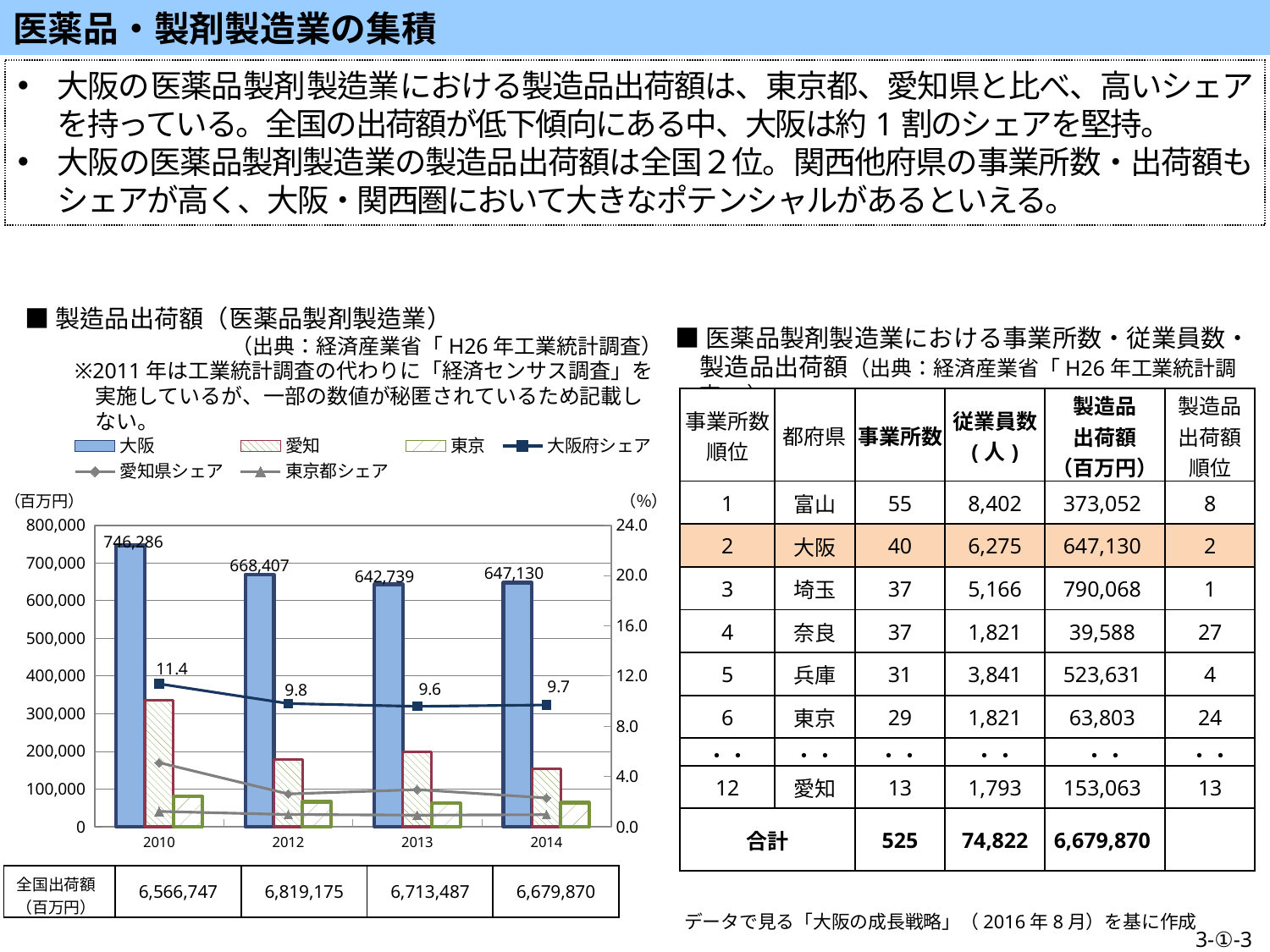
What is the value for 大阪 in 2010 in the 製造品出荷額 chart? 746,286 How many years are shown on the x axis of the 製造品出荷額 chart? 4 Is the value for 愛知 in 2010 greater or less than 300,000 in the 製造品出荷額 chart? greater Does the 大阪府シェア line rise or fall from 2010 to 2013 in the 製造品出荷額 chart? fall What is the 大阪府シェア value for 2013 in the 製造品出荷額 chart? 9.6 What is the 大阪府シェア value for 2012 in the 製造品出荷額 chart? 9.8 Which is larger in the 製造品出荷額 chart: the 大阪 value for 2013 or for 2014? 2014 In which year is the 大阪府シェア line lowest in the 製造品出荷額 chart? 2013 How many series does the legend of the 製造品出荷額 chart list? 6 What is the difference between the 大阪 values for 2010 and 2012 in the 製造品出荷額 chart? 77,879 In which year is the 大阪 bar highest in the 製造品出荷額 chart? 2010 What is the value for 大阪 in 2014 in the 製造品出荷額 chart? 647,130